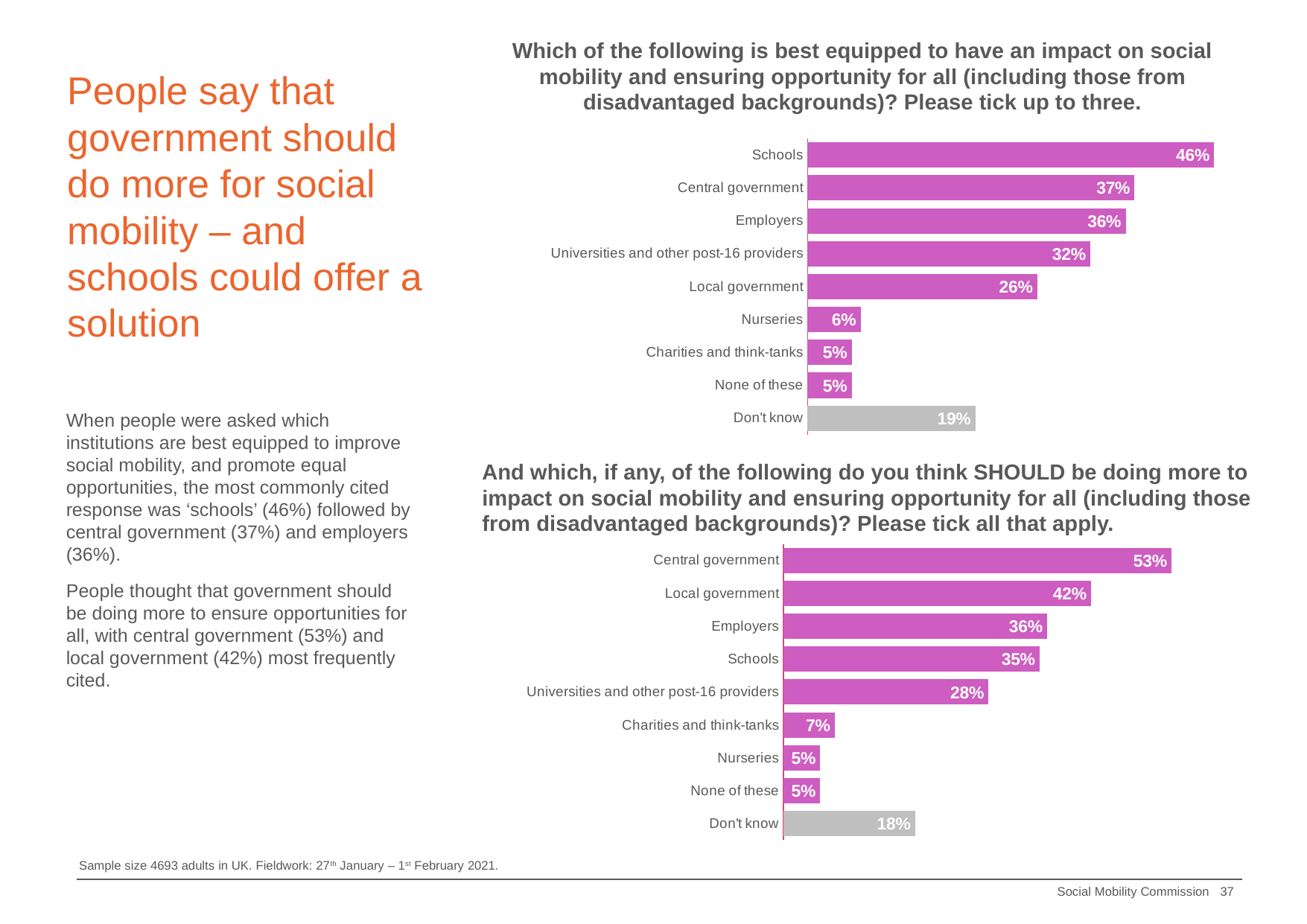
In the bottom chart ('...SHOULD be doing more...'), what percentage is shown for Don't know? 18% In the top chart ('Which of the following is best equipped...'), what percentage is shown for Schools? 46% In the top chart ('Which of the following is best equipped...'), what is the difference between the values for Schools and Central government? 9 percentage points How many categories are shown in the top chart ('Which of the following is best equipped...')? 9 In the bottom chart ('...SHOULD be doing more...'), which category has the highest value? Central government In the top chart ('Which of the following is best equipped...'), what percentage is shown for Local government? 26% In the top chart ('Which of the following is best equipped...'), which bar is coloured grey rather than pink? Don't know In the bottom chart ('...SHOULD be doing more...'), what is the difference between the values for Central government and Local government? 11 percentage points In the bottom chart ('...SHOULD be doing more...'), what percentage is shown for Central government? 53% What type of chart is the bottom chart ('...SHOULD be doing more...')? Bar chart In the bottom chart ('...SHOULD be doing more...'), which is larger: the value for Employers or the value for Schools? Employers In the top chart ('Which of the following is best equipped...'), which category has the highest value? Schools